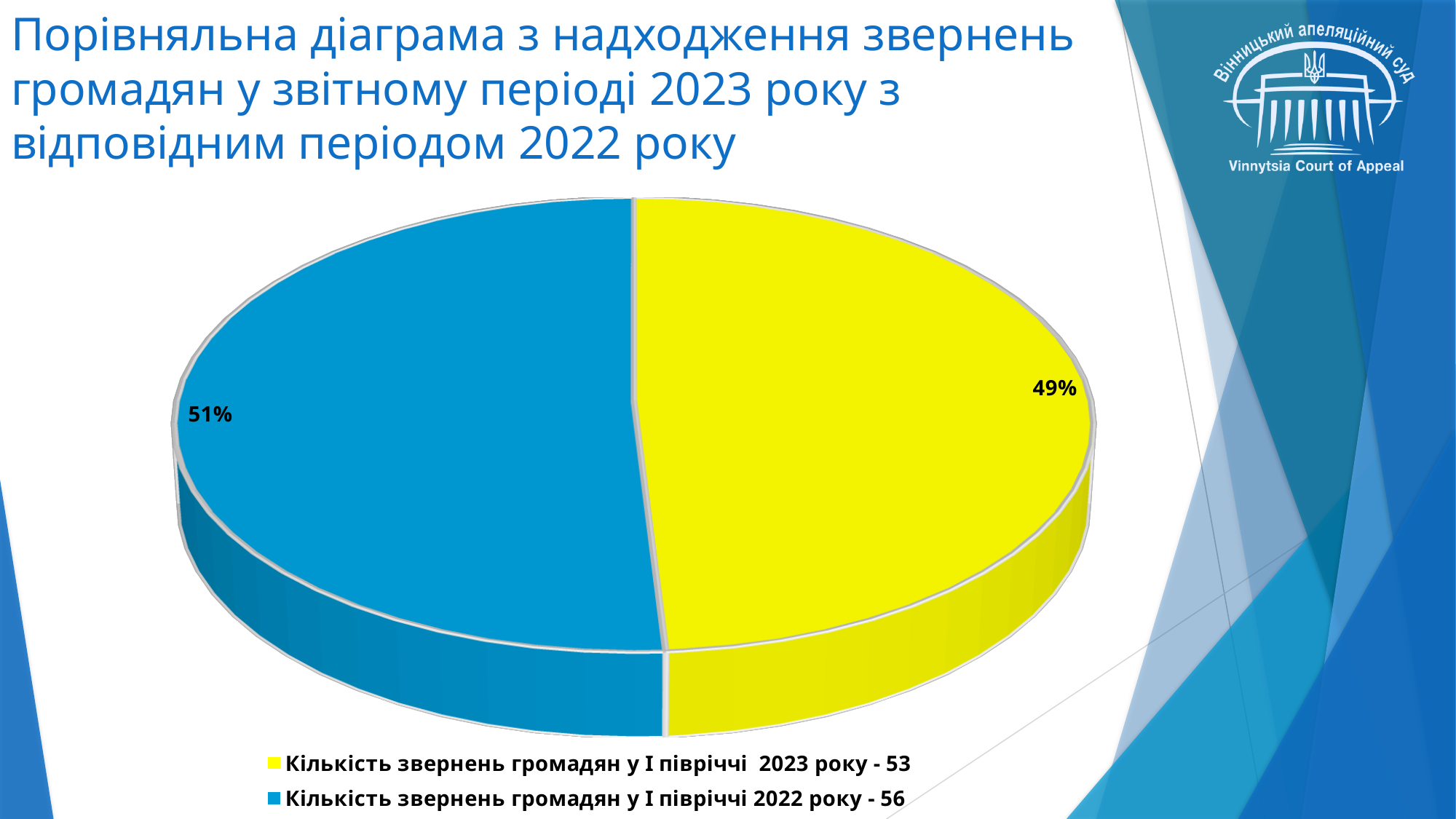
What share of the pie does the slice for appeals in the first half of 2023 (Кількість звернень громадян у І півріччі 2023 року) represent? 49% What colour is the slice representing the first half of 2023? yellow According to the legend, how many citizen appeals were received in the first half of 2023? 53 What is the difference between the number of appeals in the first half of 2022 and the first half of 2023, using the counts in the legend? 3 What share of the pie does the slice for appeals in the first half of 2022 (Кількість звернень громадян у І півріччі 2022 року) represent? 51% What kind of chart is shown on the slide? pie chart How many entries does the legend list? 2 Which period has the larger slice of the pie, the first half of 2023 or the first half of 2022? first half of 2022 Which period has the smallest share of the pie? first half of 2023 What colour is the slice representing the first half of 2022? blue How many slices does the pie chart have? 2 According to the legend, how many citizen appeals were received in the first half of 2022? 56